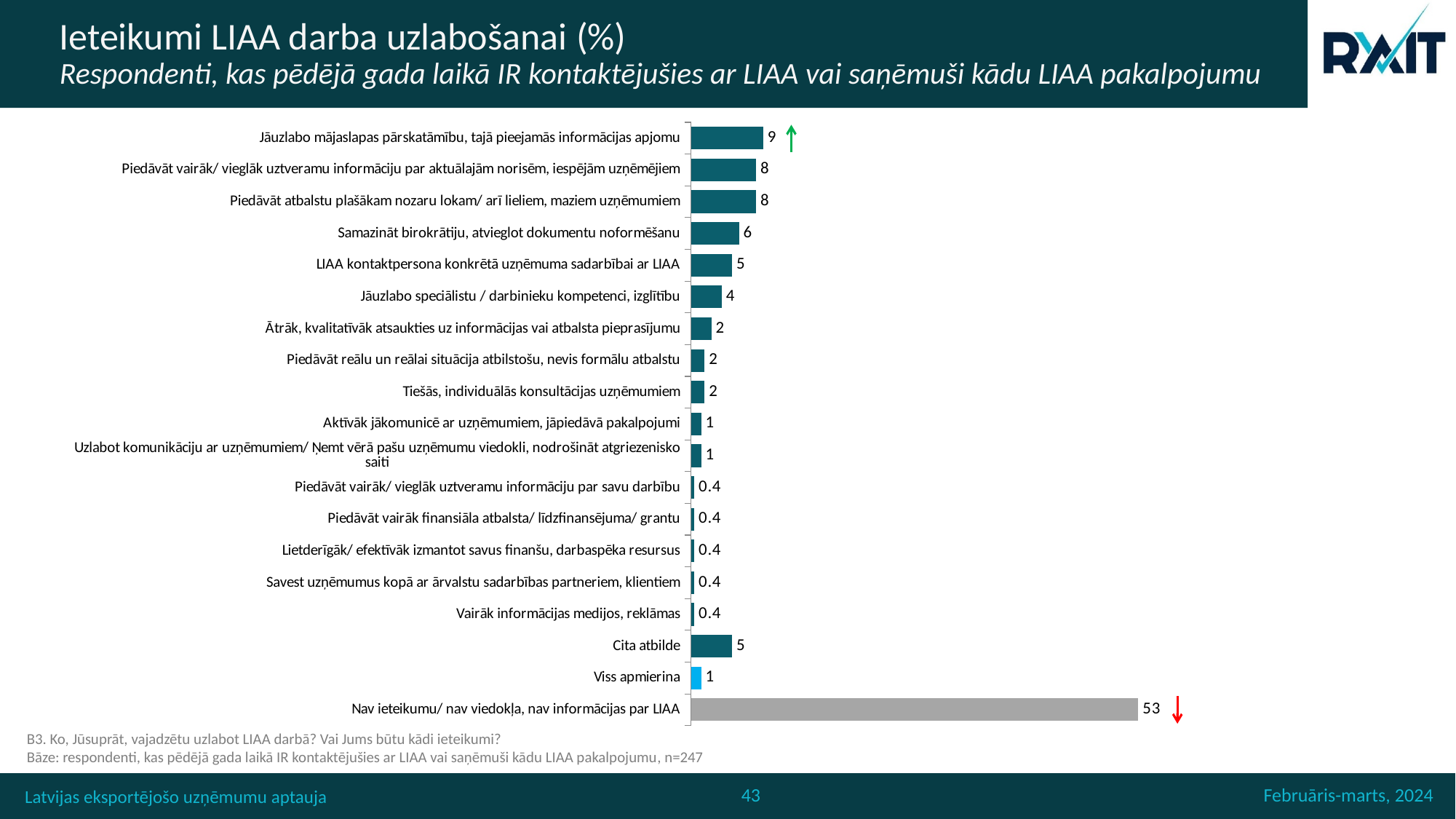
What is the difference between the values for "Samazināt birokrātiju, atvieglot dokumentu noformēšanu" and "Jāuzlabo speciālistu / darbinieku kompetenci, izglītību"? 2 How many categories are shown in the chart? 19 Which category has the highest value? Nav ieteikumu/ nav viedokļa, nav informācijas par LIAA What is the difference between the values for "Nav ieteikumu/ nav viedokļa, nav informācijas par LIAA" and "Jāuzlabo mājaslapas pārskatāmību, tajā pieejamās informācijas apjomu"? 44 What is the value for "Viss apmierina"? 1 What is the value for "Nav ieteikumu/ nav viedokļa, nav informācijas par LIAA"? 53 Which is larger: the value for "LIAA kontaktpersona konkrētā uzņēmuma sadarbībai ar LIAA" or the value for "Ātrāk, kvalitatīvāk atsaukties uz informācijas vai atbalsta pieprasījumu"? LIAA kontaktpersona konkrētā uzņēmuma sadarbībai ar LIAA What is the value for "Jāuzlabo mājaslapas pārskatāmību, tajā pieejamās informācijas apjomu"? 9 What is the value for "Samazināt birokrātiju, atvieglot dokumentu noformēšanu"? 6 What is the value for "Cita atbilde"? 5 What is the value for "Vairāk informācijas medijos, reklāmas"? 0.4 What kind of chart is shown on the slide? Bar chart